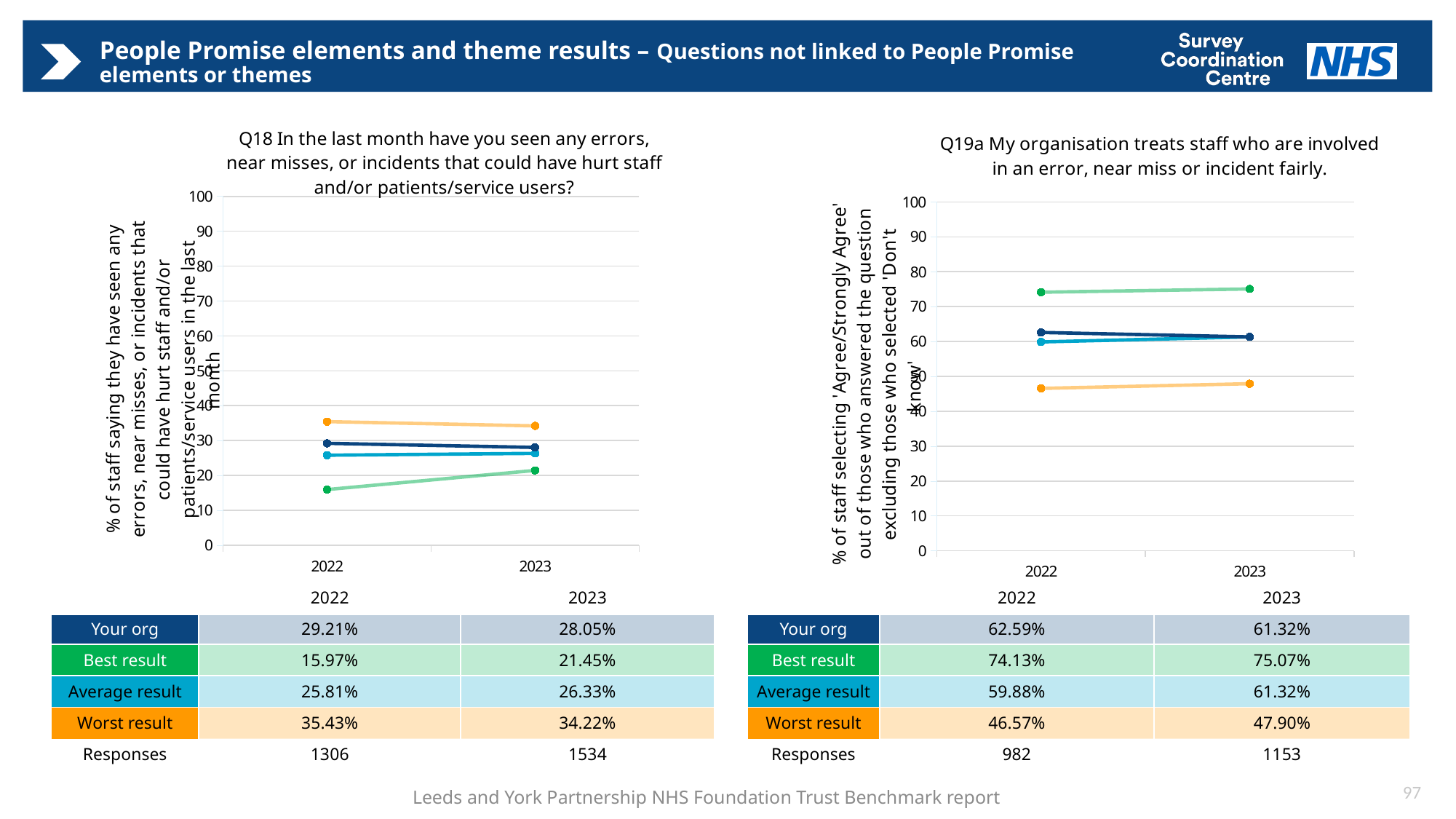
In the Q18 chart, what is the Best result value in 2023? 21.45% In the Q19a chart, is the Best result value for 2023 greater or less than 70? greater In the Q18 chart, what is the value for Your org in 2022? 29.21% In the Q18 chart, which series has the highest value in 2022? Worst result In the Q19a chart, what is the difference between the Best result and Your org in 2022? 11.54% In the Q18 chart, is the Your org value higher in 2022 or 2023? 2022 How many lines are plotted in the Q18 chart? 4 In the Q19a chart, what is the Worst result value in 2023? 47.90% What type of chart is used for Q19a? line chart In the Q19a chart, what is the Average result value in 2022? 59.88% In the Q18 chart, does the Best result line rise or fall from 2022 to 2023? rise In the Q19a chart, which series has the lowest value in 2023? Worst result